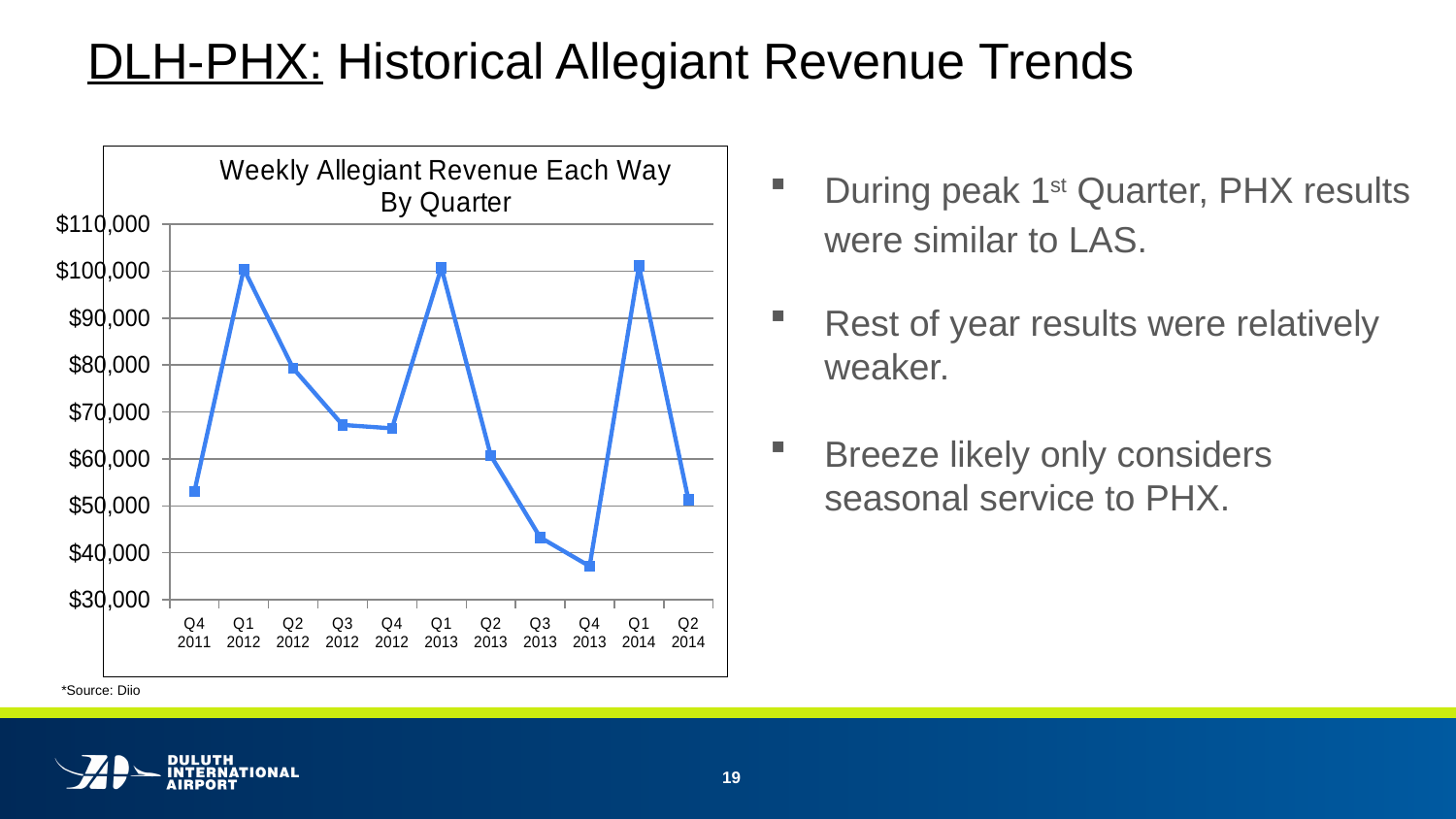
Is the value for Q2 2014 greater or less than $60,000? less Which quarter has the lowest weekly Allegiant revenue? Q4 2013 Which is larger, the value for Q2 2012 or the value for Q3 2012? Q2 2012 What is the title of the chart? Weekly Allegiant Revenue Each Way By Quarter Is the value for Q2 2012 greater or less than $70,000? greater What kind of chart is shown on the slide? line chart Do the values rise or fall from Q1 2013 to Q4 2013? fall Is the value for Q1 2013 greater or less than $90,000? greater Which is larger, the value for Q4 2011 or the value for Q4 2013? Q4 2011 How many quarters are plotted on the x axis of the chart? 11